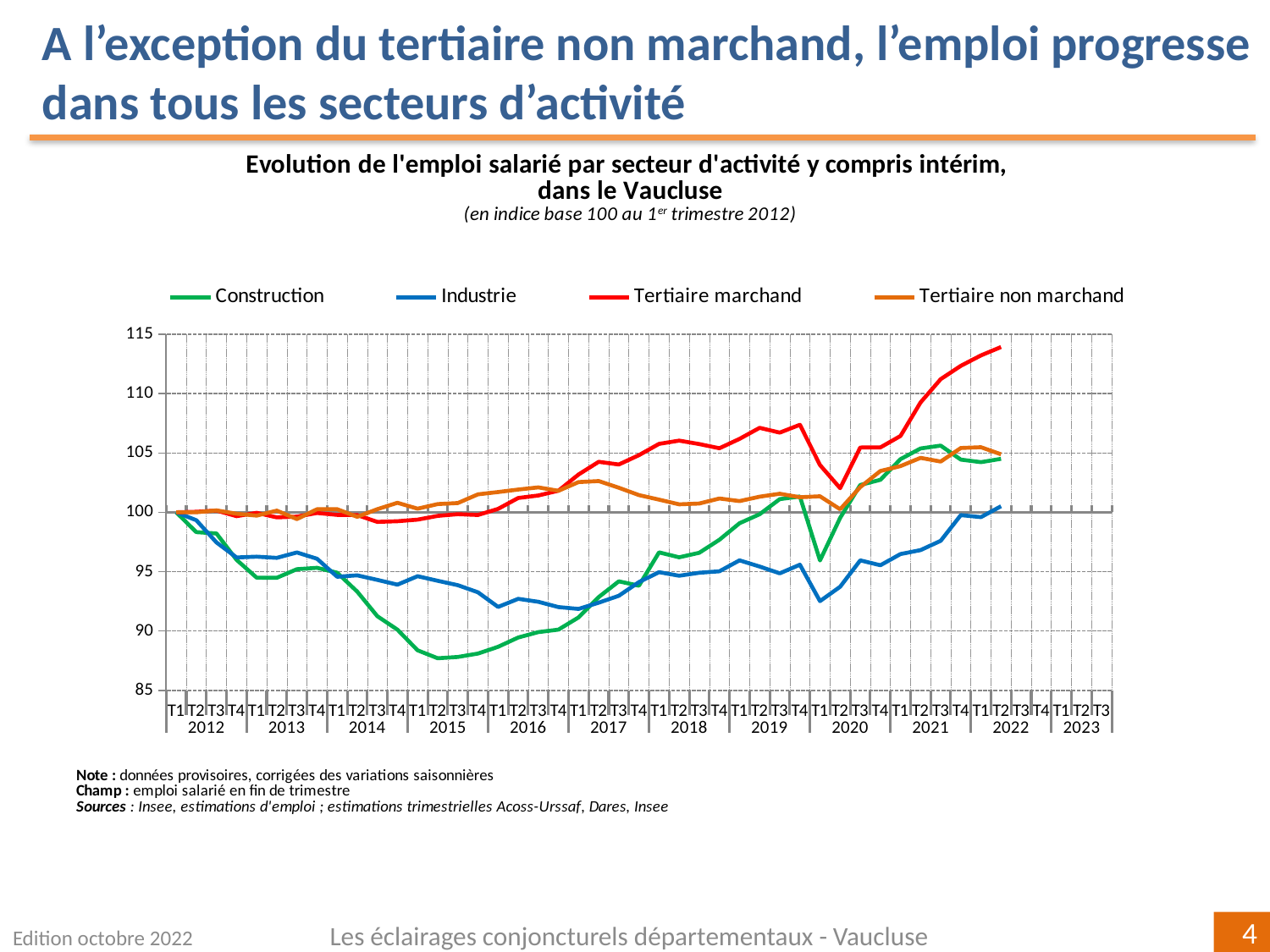
Is the value for Tertiaire marchand at T2 2022 greater or less than 110? greater What kind of chart is shown on the slide? line chart At T1 2020, which is larger: Construction or Industrie? Construction Which colour is used for the Tertiaire non marchand series? orange Does the Construction series rise or fall between T1 2012 and T2 2015? fall What is the value of every series at T1 2012, the base period of the index? 100 Is the value for Construction at T2 2015 greater or less than 90? less Which series has the highest value at the last plotted point (T2 2022)? Tertiaire marchand Which series has the lowest value at the last plotted point (T2 2022)? Industrie Which series has the lowest value during 2015? Construction How many series does the legend list? 4 Is the value for Industrie at T1 2020 greater or less than 95? less